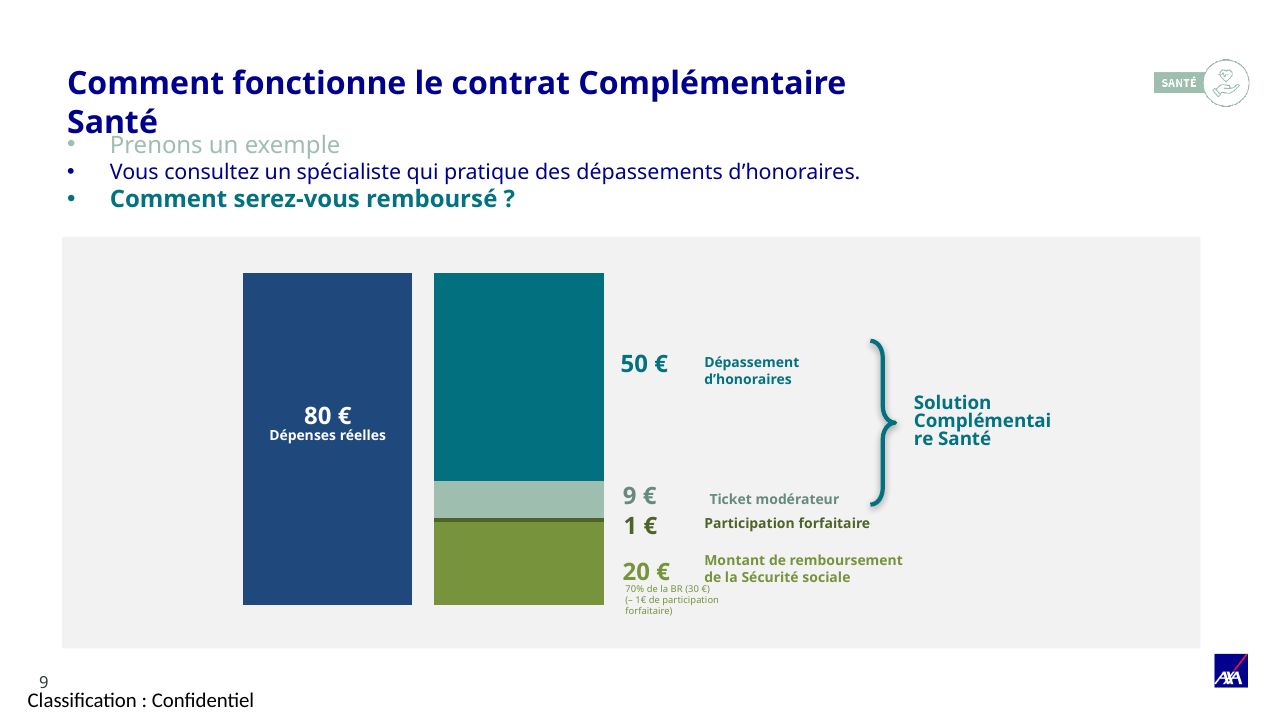
What is the total of the four segments in the stacked bar? 80 € What is the value of the Ticket modérateur segment? 9 € How many segments make up the stacked bar? 4 What is the value of the Dépassement d'honoraires segment? 50 € What is the value shown for Dépenses réelles? 80 € Which segment of the stacked bar has the smallest value? Participation forfaitaire What is the difference between the Dépassement d'honoraires and the Montant de remboursement de la Sécurité sociale? 30 € What kind of chart is shown on the slide? Bar chart What is the Montant de remboursement de la Sécurité sociale? 20 € Which is larger, the Ticket modérateur or the Montant de remboursement de la Sécurité sociale? Montant de remboursement de la Sécurité sociale What is the value of the Participation forfaitaire segment? 1 € Which segment of the stacked bar has the largest value? Dépassement d'honoraires